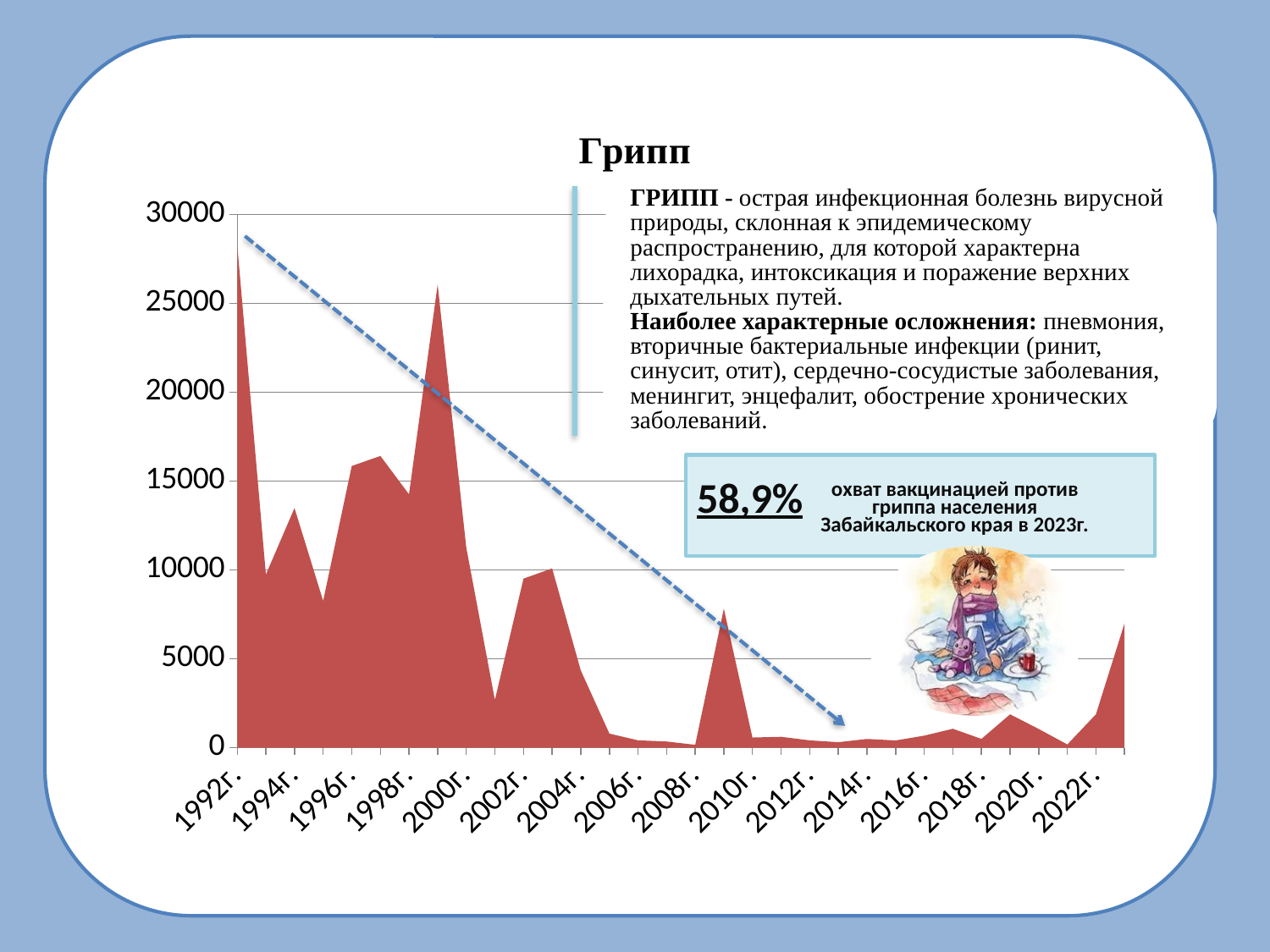
Which is larger, the value for 1996г. or the value for 2004г.? 1996г. How many year labels are shown on the x axis of the chart? 16 Is the value for 2012г. greater or less than 5000? less Which is larger, the value for 1992г. or the value for 2000г.? 1992г. Is the value for 2000г. greater or less than 20000? less What kind of chart is shown on the slide? area chart Which year has the highest value on the chart? 1992г. Is the value for 1994г. greater or less than 10000? greater What is the title of the chart? Грипп Do the values on the chart generally rise or fall from 1992г. to 2022г.? fall